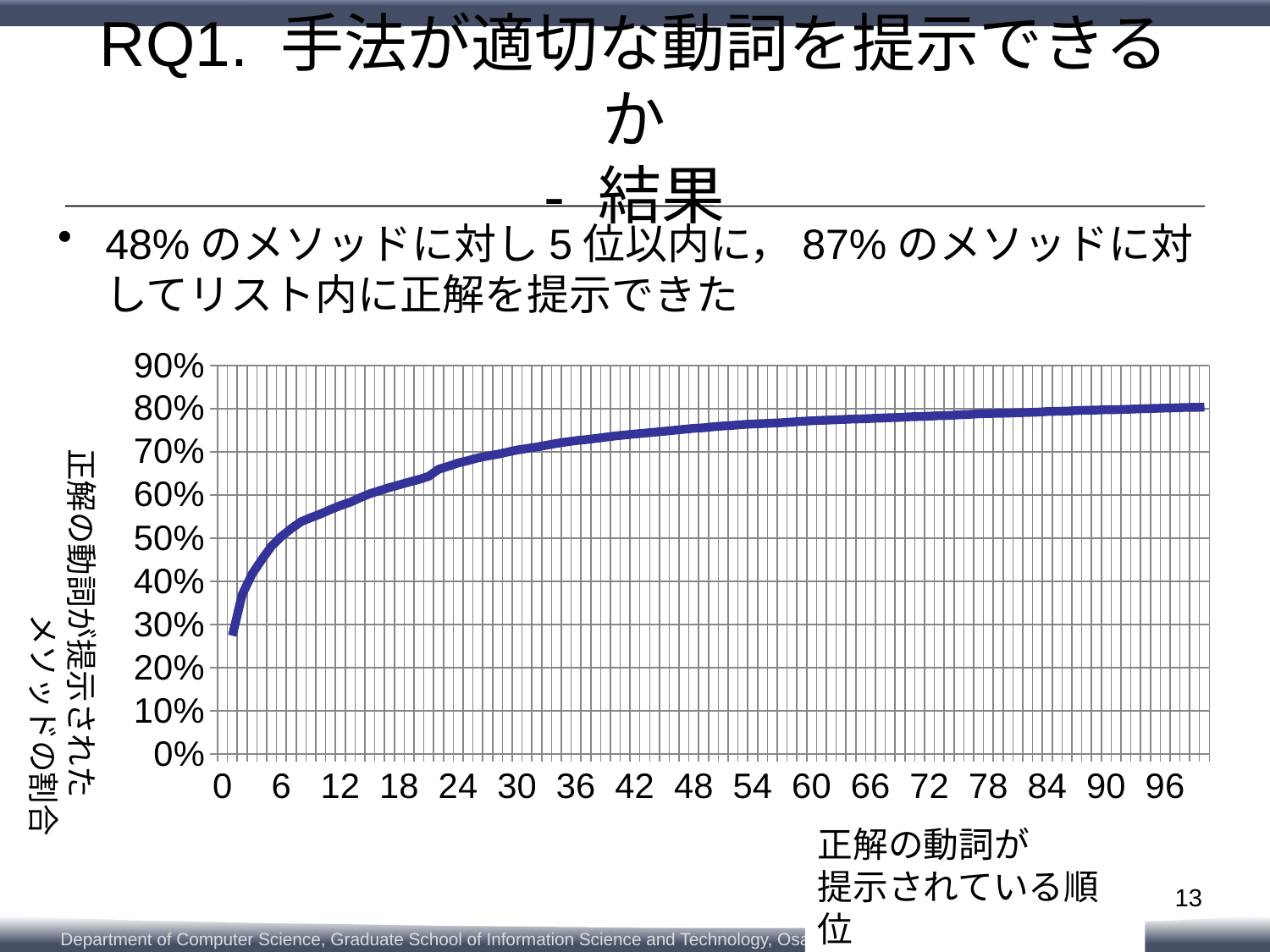
Is the value of the line at rank 12 greater or less than 50%? greater Is the value of the line at rank 48 greater or less than 70%? greater What kind of chart is shown on the slide? line chart What is the highest value labelled on the y axis? 90% Is the value of the line at rank 6 greater or less than 30%? greater How many lines are plotted on the chart? 1 What is the largest value labelled on the x axis? 96 Does the plotted line rise or fall as the rank on the x axis increases? rise